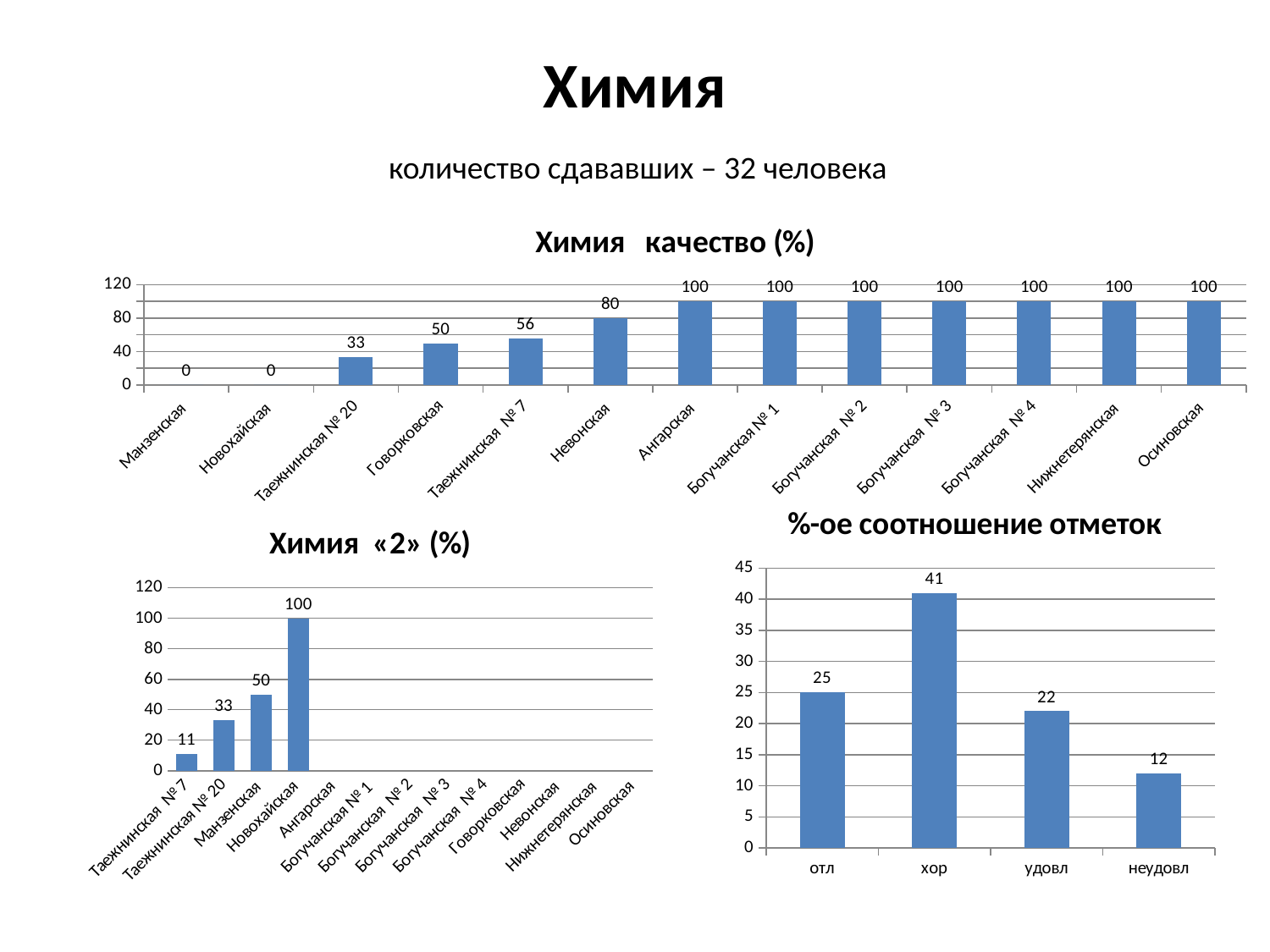
In the chart "Химия «2» (%)", which category has the highest value? Новохайская In the chart "%-ое соотношение отметок", what is the difference between the values for отл and удовл? 3 In the chart "%-ое соотношение отметок", what is the value for хор? 41 In the chart "%-ое соотношение отметок", which category has the lowest value? неудовл In the chart "Химия качество (%)", do the values rise or fall from left to right along the x axis? rise In the chart "Химия качество (%)", what is the value for Таежнинская № 7? 56 In the chart "Химия качество (%)", what is the difference between the values for Говорковская and Таежнинская № 20? 17 In the chart "Химия качество (%)", how many categories are shown on the x axis? 13 In the chart "Химия «2» (%)", which is larger, the value for Таежнинская № 7 or the value for Таежнинская № 20? Таежнинская № 20 What kind of chart is "%-ое соотношение отметок"? bar chart In the chart "Химия «2» (%)", what is the value for Манзенская? 50 In the chart "Химия качество (%)", what is the value for Невонская? 80